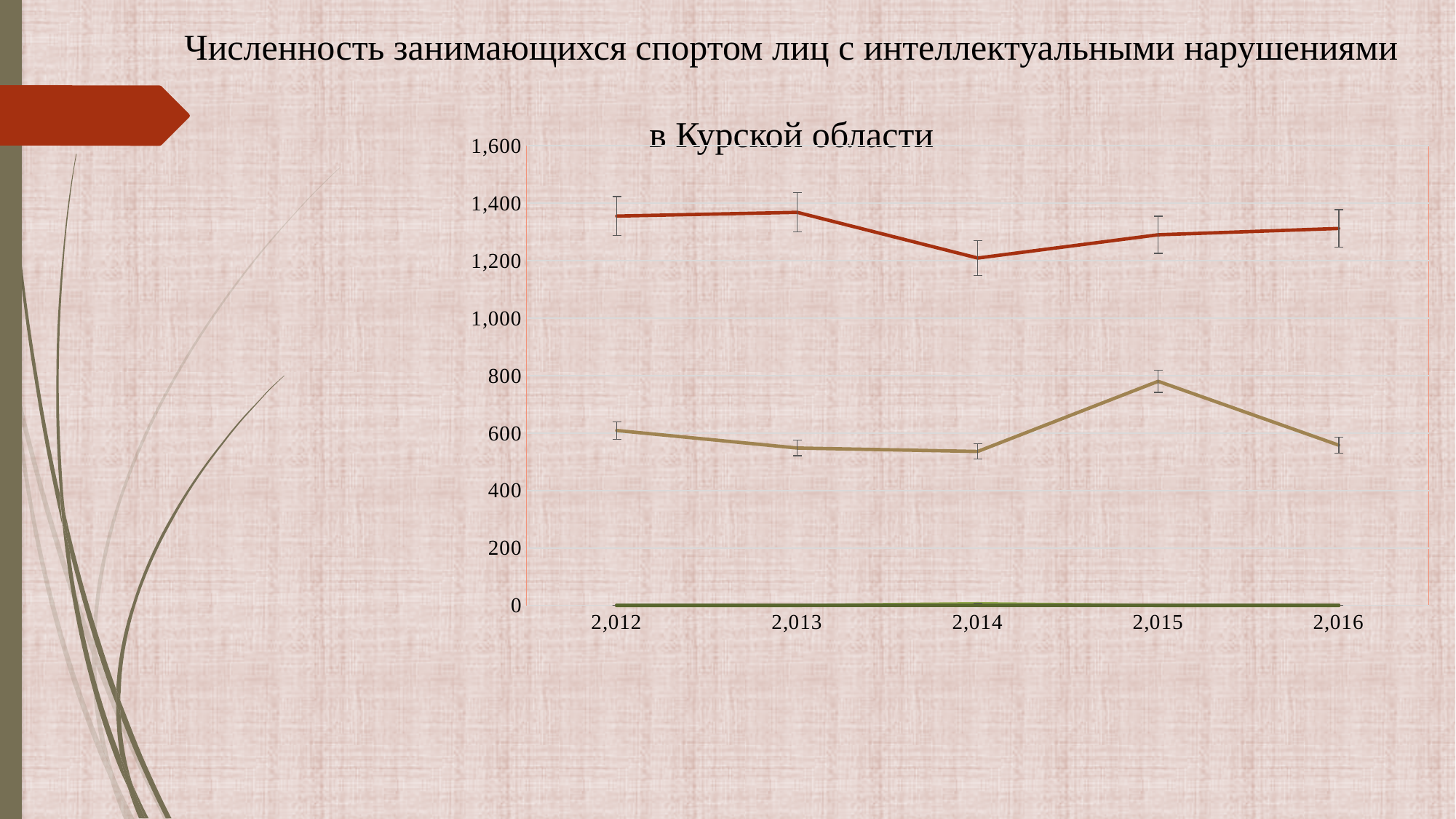
Is the value of the red line in 2,014 greater or less than 1,400? less In which year does the tan (gold) line reach its highest point? 2,015 In 2,014, which line has the larger value, the red line or the tan (gold) line? the red line What is the first year shown on the x axis? 2,012 How many years are plotted along the x axis? 5 Is the value of the tan (gold) line in 2,013 greater or less than 600? less Is the value of the tan (gold) line in 2,015 greater or less than 600? greater In which year does the red line reach its lowest point? 2,014 Does the tan (gold) line rise or fall from 2,015 to 2,016? fall What kind of chart is shown on the slide? line chart What is the highest value shown on the y axis? 1,600